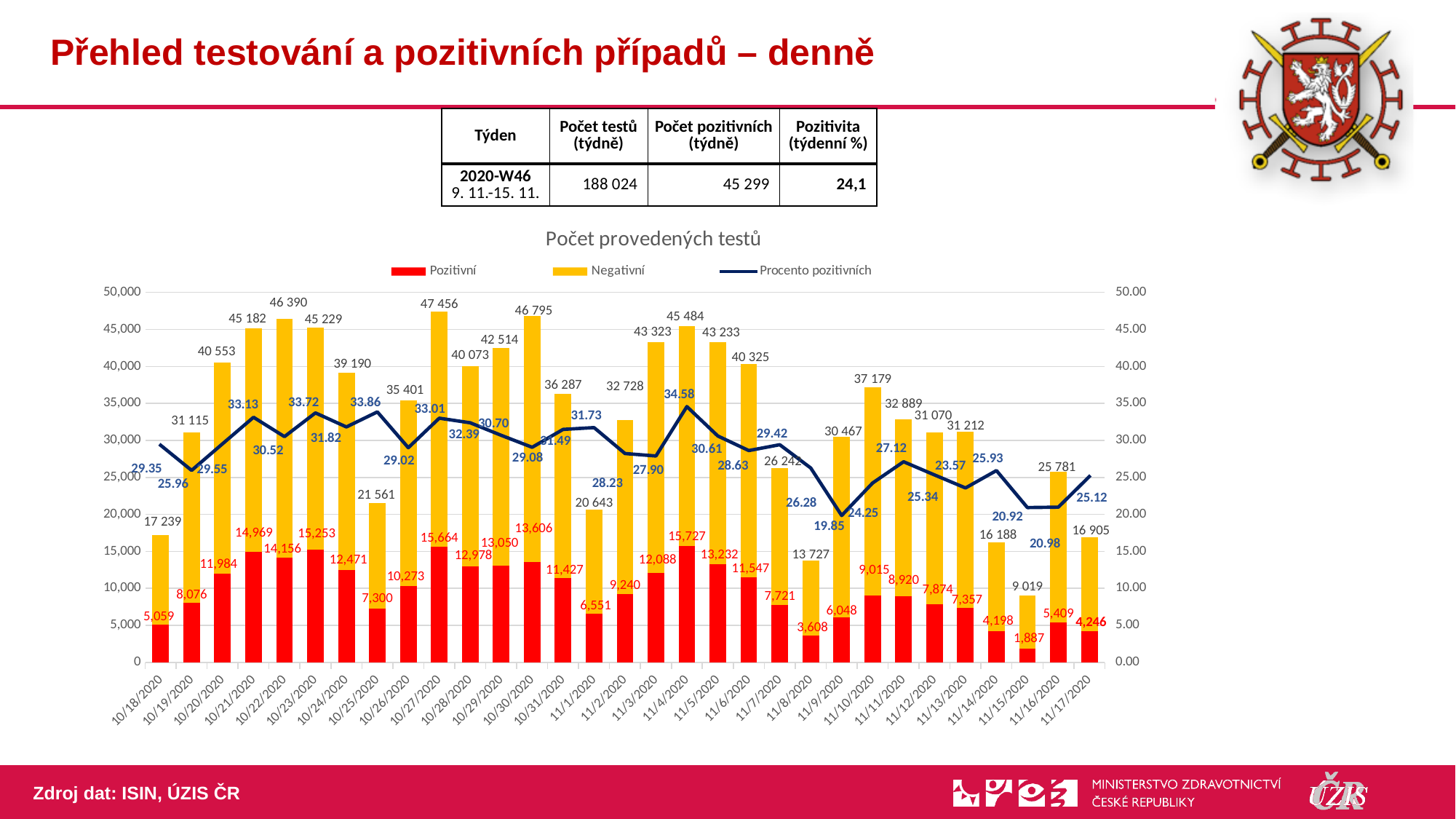
On which date is the total number of tests the highest? 10/27/2020 What is the Pozitivní value for 11/4/2020? 15,727 What is the Procento pozitivních value for 11/9/2020? 19.85 Is the total number of tests for 11/16/2020 greater or less than 30,000? less Which date has the larger Pozitivní value, 10/21/2020 or 10/22/2020? 10/21/2020 How many series does the chart legend list? 3 What is the difference between the total tests on 10/27/2020 and on 10/18/2020? 30 217 On which date does the Procento pozitivních line reach its highest value? 11/4/2020 How many dates are shown on the x axis of the chart? 31 On which date is the total number of tests the lowest? 11/15/2020 What is the total number of tests shown above the bar for 10/27/2020? 47 456 What type of chart is shown on the slide? Bar chart with a line